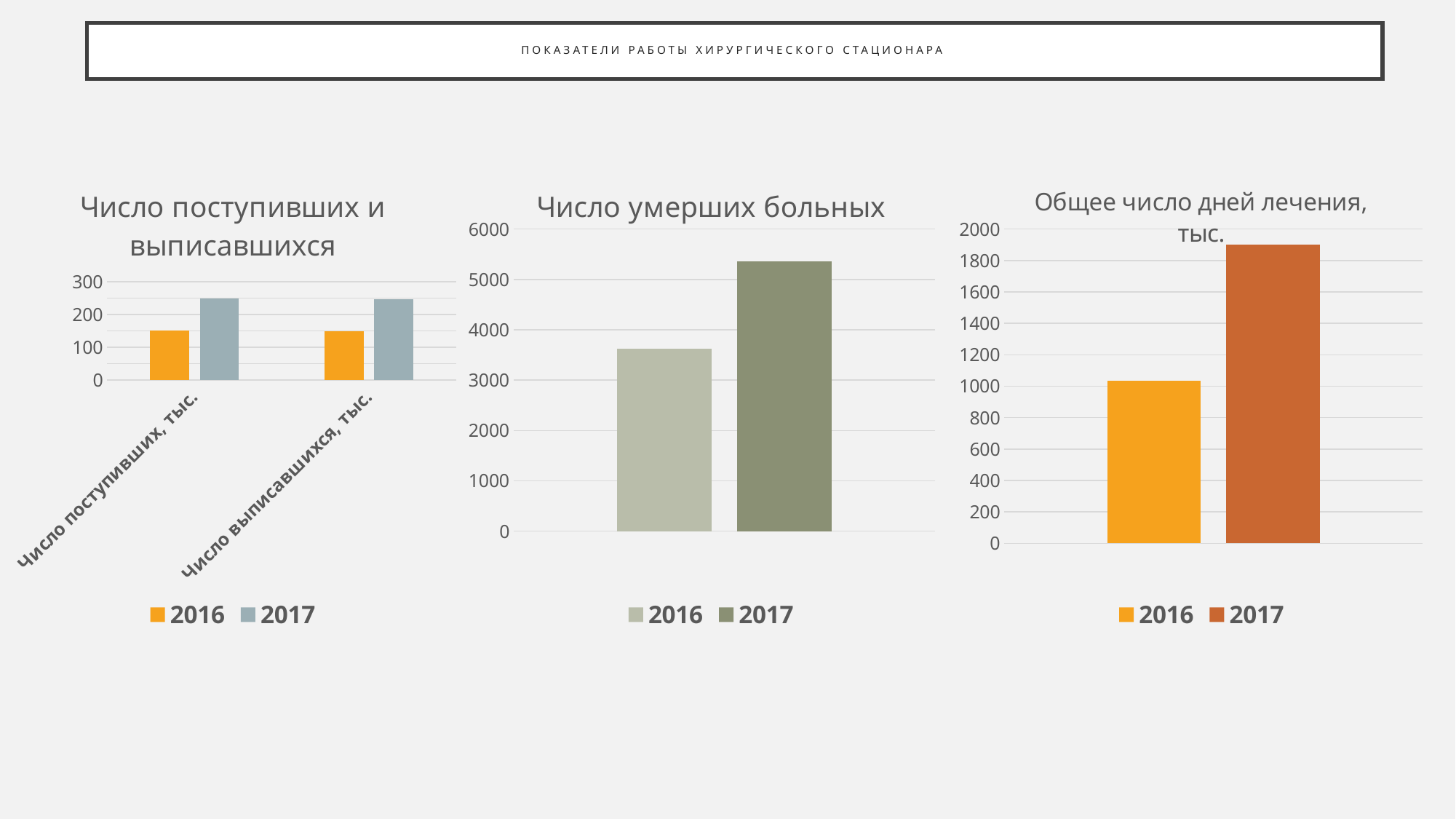
In the chart titled "Число поступивших и выписавшихся", how many categories are shown on the x axis? 2 What is the title of the rightmost chart on the slide? Общее число дней лечения, тыс. In the chart titled "Общее число дней лечения, тыс.", is the value for 2016 greater or less than 1200? less In the chart titled "Число поступивших и выписавшихся", how many series does the legend list? 2 In the chart titled "Число поступивших и выписавшихся", is the 2017 value for "Число поступивших, тыс." greater or less than 200? greater What type of chart is the chart titled "Число умерших больных"? bar chart In the chart titled "Общее число дней лечения, тыс.", which year has the lower value? 2016 In the chart titled "Общее число дней лечения, тыс.", is the value for 2017 greater or less than 1800? greater In the chart titled "Число умерших больных", which year has the higher value, 2016 or 2017? 2017